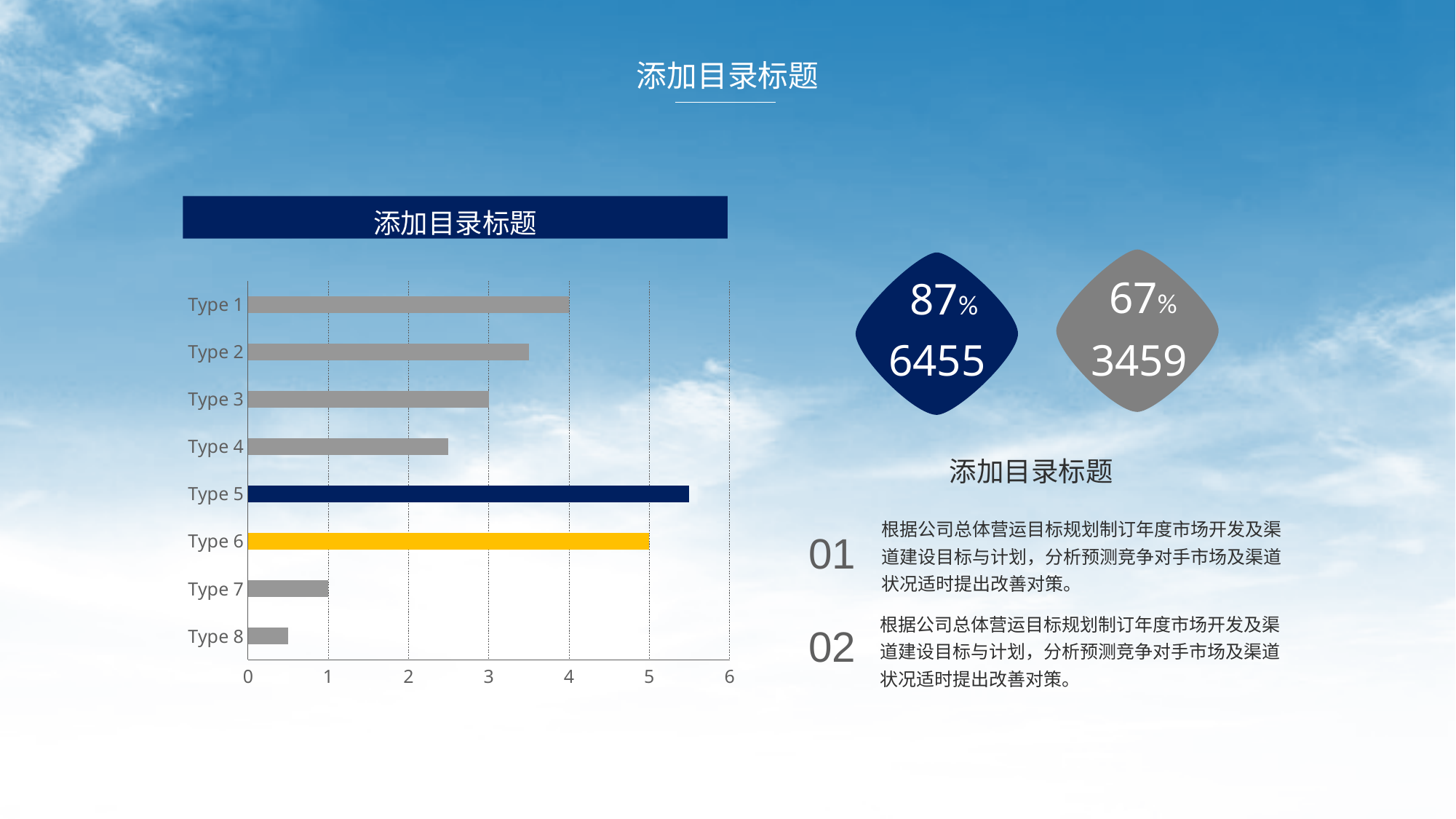
What is the value for Type 1 in the bar chart? 4 Which category has the lowest value in the bar chart? Type 8 Is the value for Type 4 greater or less than 3? less Which is larger, the value for Type 5 or the value for Type 6? Type 5 What is the difference between the values for Type 1 and Type 3? 1 What kind of chart is shown on the slide? bar chart Which category has the highest value in the bar chart? Type 5 What colour is the bar for Type 6? yellow How many categories does the bar chart show? 8 What is the value for Type 7 in the bar chart? 1 Is the value for Type 2 greater or less than 3? greater What is the value for Type 6 in the bar chart? 5